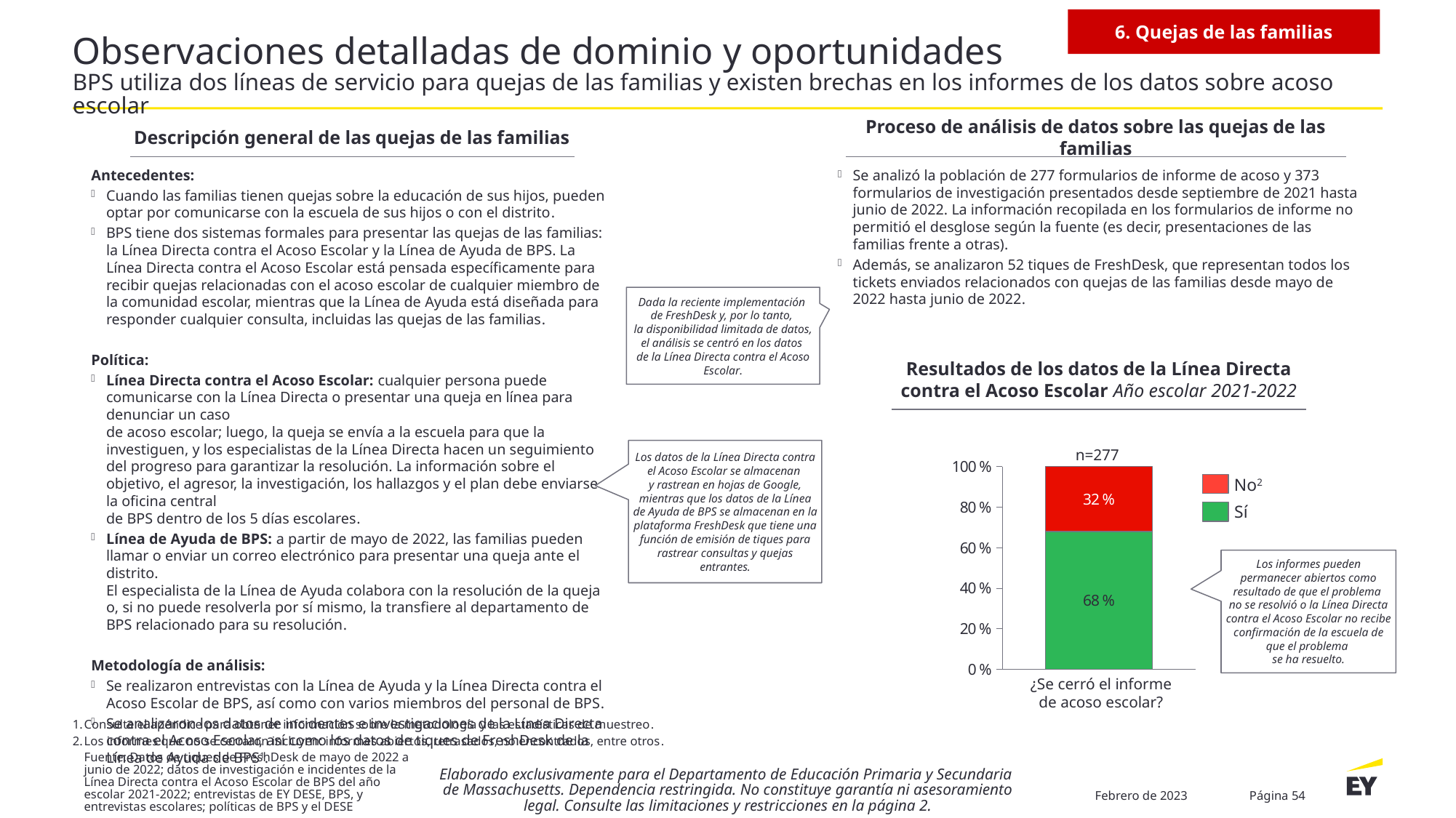
How many series does the chart legend list? 2 Which segment of the bar is larger, "Sí" or "No"? Sí What is the sample size (n) shown above the bar? n=277 What is the total of the stacked bar? 100 % What is the difference in percentage points between the "Sí" and "No" segments? 36 % Is the value for "Sí" greater or less than 60 %? greater What percentage of bullying hotline reports were not closed ("No")? 32 % Is the value for "No" greater or less than 40 %? less What percentage of bullying hotline reports were closed ("Sí")? 68 % What kind of chart is shown on the slide? Stacked bar chart What colour represents the "Sí" segment in the chart? Green What is the category label on the x axis of the chart? ¿Se cerró el informe de acoso escolar?